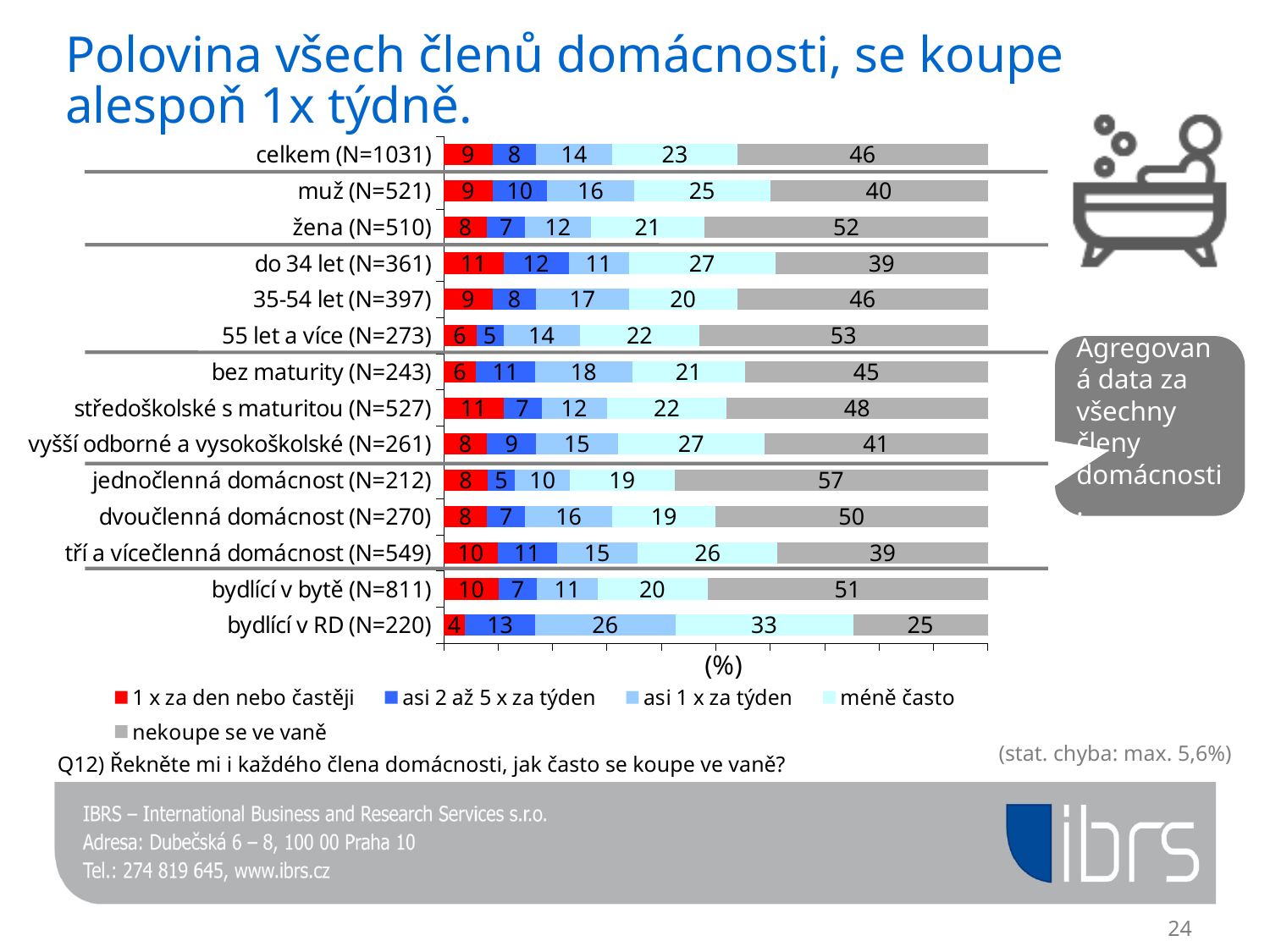
What is the total of the stacked bar for 'celkem (N=1031)'? 100 Which legend entry is shown in red? 1 x za den nebo častěji How many categories (rows) are plotted in the chart? 14 What is the value of '1 x za den nebo častěji' for 'do 34 let (N=361)'? 11 What is the value of 'asi 1 x za týden' for 'bydlící v RD (N=220)'? 26 Which category has the lowest value for '1 x za den nebo častěji'? bydlící v RD (N=220) What type of chart is shown on the slide? stacked bar chart Which has a larger 'méně často' value: 'bydlící v RD (N=220)' or 'bydlící v bytě (N=811)'? bydlící v RD (N=220) What is the value of 'nekoupe se ve vaně' for 'celkem (N=1031)'? 46 How many series does the legend list? 5 Which category has the highest value for 'nekoupe se ve vaně'? jednočlenná domácnost (N=212) What is the difference between the 'nekoupe se ve vaně' values for 'žena (N=510)' and 'muž (N=521)'? 12